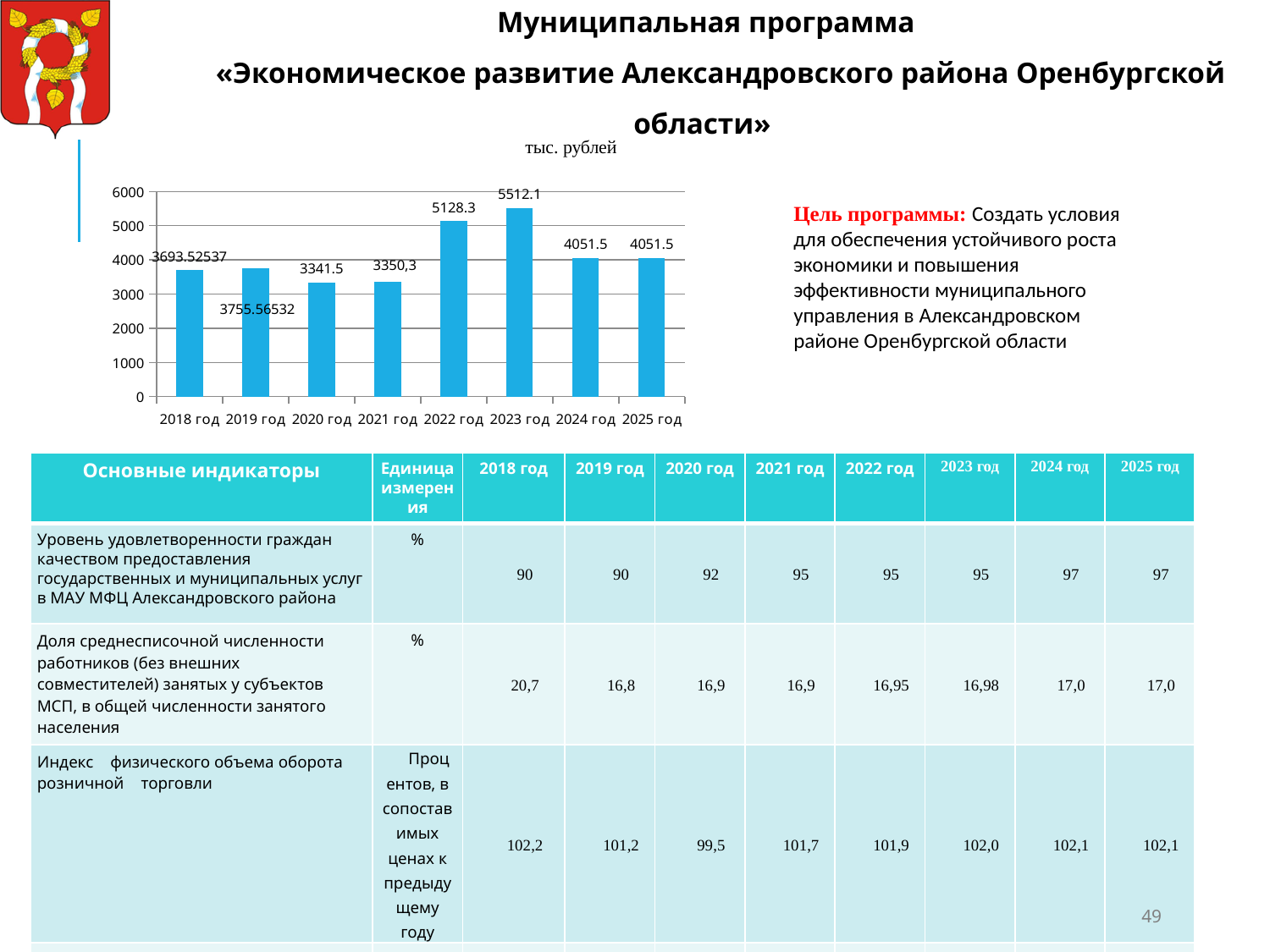
Is the value for 2018 год in the bar chart greater or less than 4000? less What is the difference between the values for 2023 год and 2022 год in the bar chart? 383.8 What is the value for 2024 год in the bar chart? 4051.5 What is the value for 2023 год in the bar chart? 5512.1 What is the title of the chart on the slide? тыс. рублей What is the value for 2018 год in the bar chart? 3693.52537 How many years are shown on the x axis of the bar chart? 8 What is the value for 2022 год in the bar chart? 5128.3 What kind of chart is shown on the slide? bar chart What is the value for 2019 год in the bar chart? 3755.56532 Which year has the highest value in the bar chart? 2023 год Which is larger in the bar chart, the value for 2022 год or the value for 2024 год? 2022 год